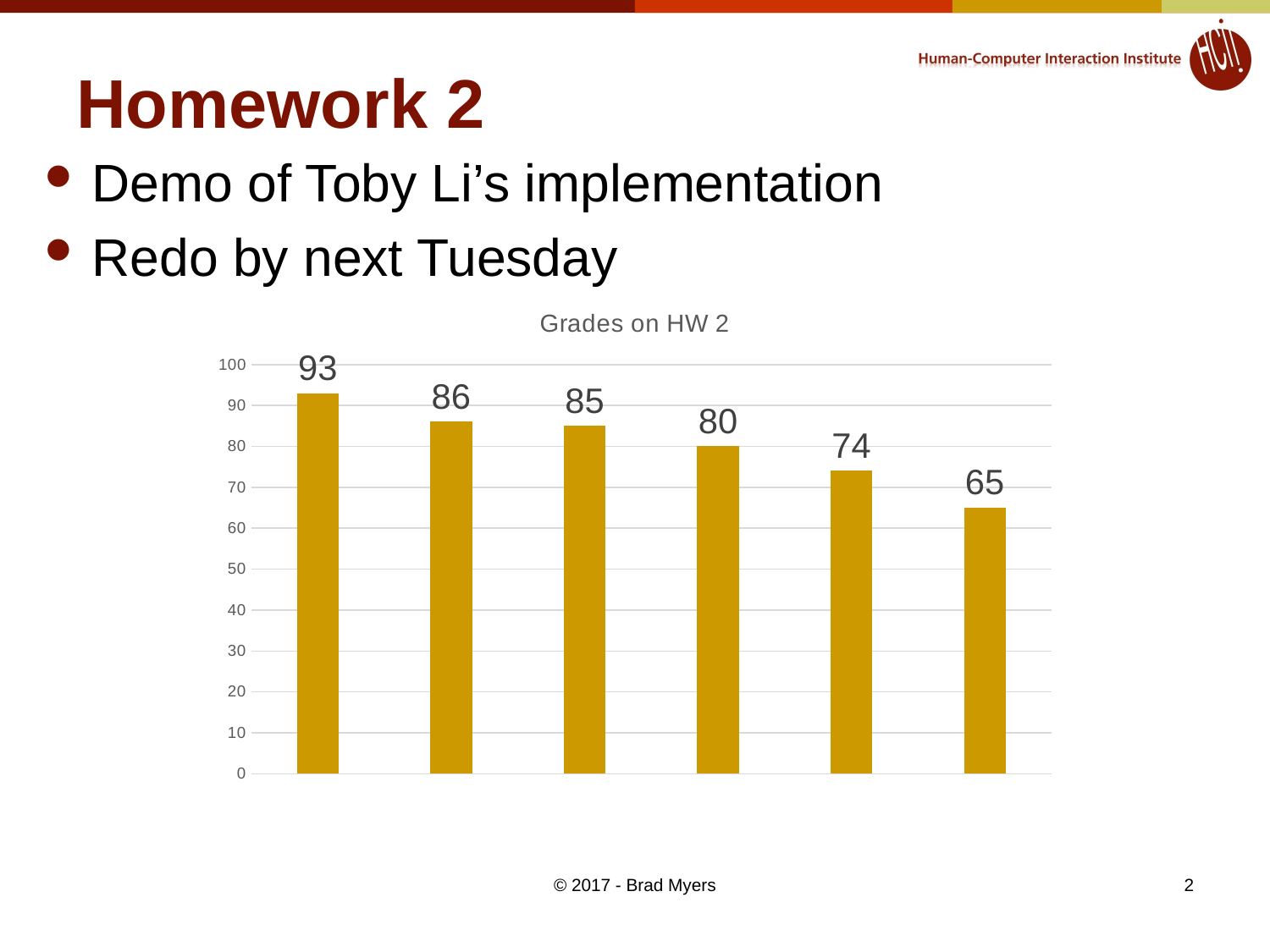
What is the value of the fourth bar from the left? 80 Do the bar values rise or fall from left to right across the chart? fall What is the value of the last (rightmost) bar? 65 What is the difference between the second bar (86) and the fifth bar (74)? 12 What is the highest value shown in the chart? 93 What is the lowest value shown in the chart? 65 What is the difference between the highest and lowest bars? 28 What kind of chart is shown on the slide? bar chart How many bars are plotted in the chart? 6 Which is larger, the third bar or the fourth bar? the third bar (85) What is the value of the first (leftmost) bar? 93 What is the title of the chart? Grades on HW 2